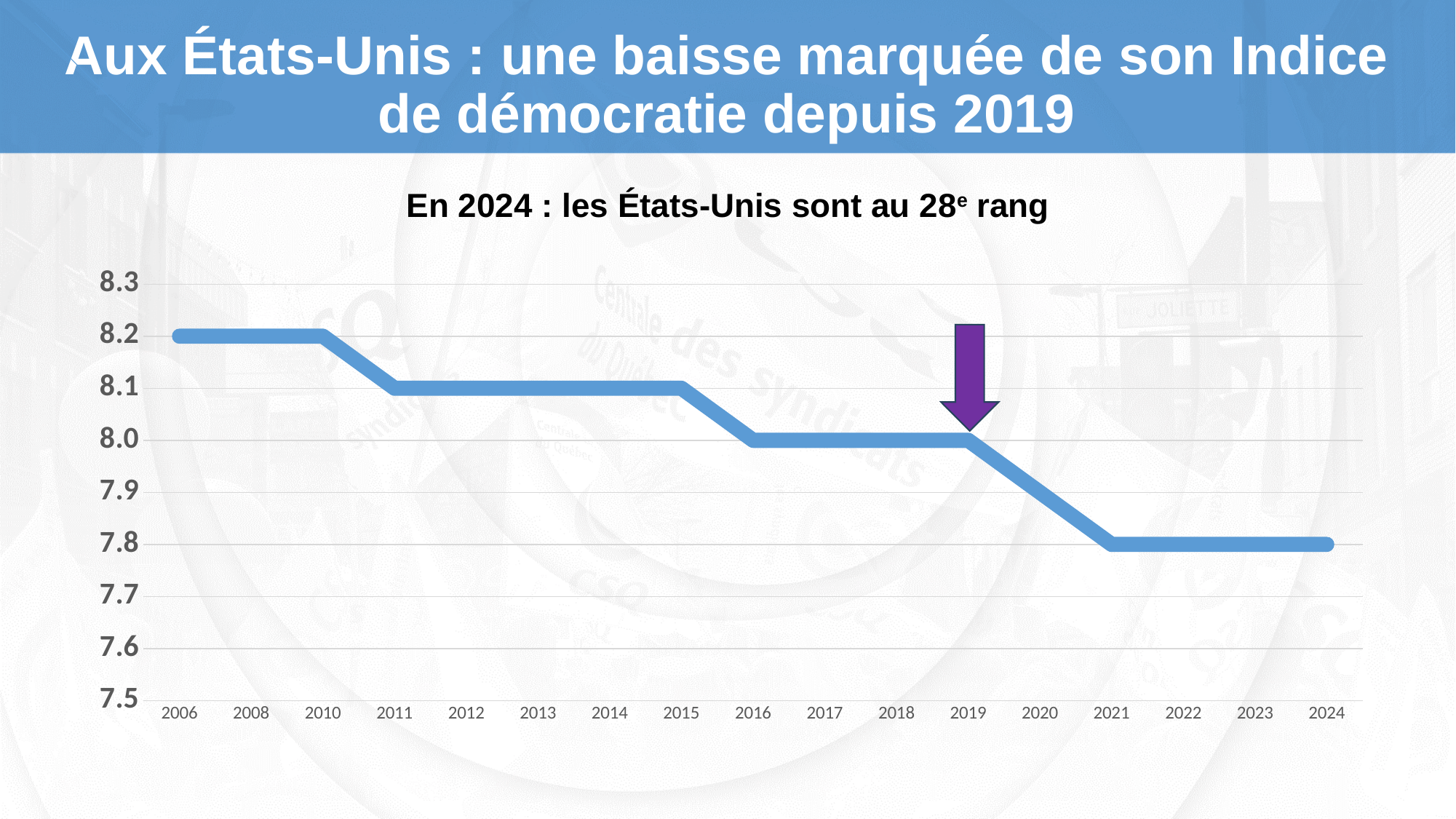
What is the value of the democracy index for 2019? 8.0 What kind of chart is shown on the slide? line chart Which is larger, the value for 2010 or the value for 2021? 2010 Is the value for 2020 greater or less than 8.0? less What is the value of the democracy index for 2024? 7.8 How many years are plotted on the x axis? 17 What is the value of the democracy index for 2006? 8.2 What is the difference between the democracy index in 2006 and in 2024? 0.4 What is the value of the democracy index for 2013? 8.1 Which year does the purple arrow on the chart point to? 2019 Do the values rise or fall from 2006 to 2024? fall Is the value for 2016 greater or less than 7.9? greater